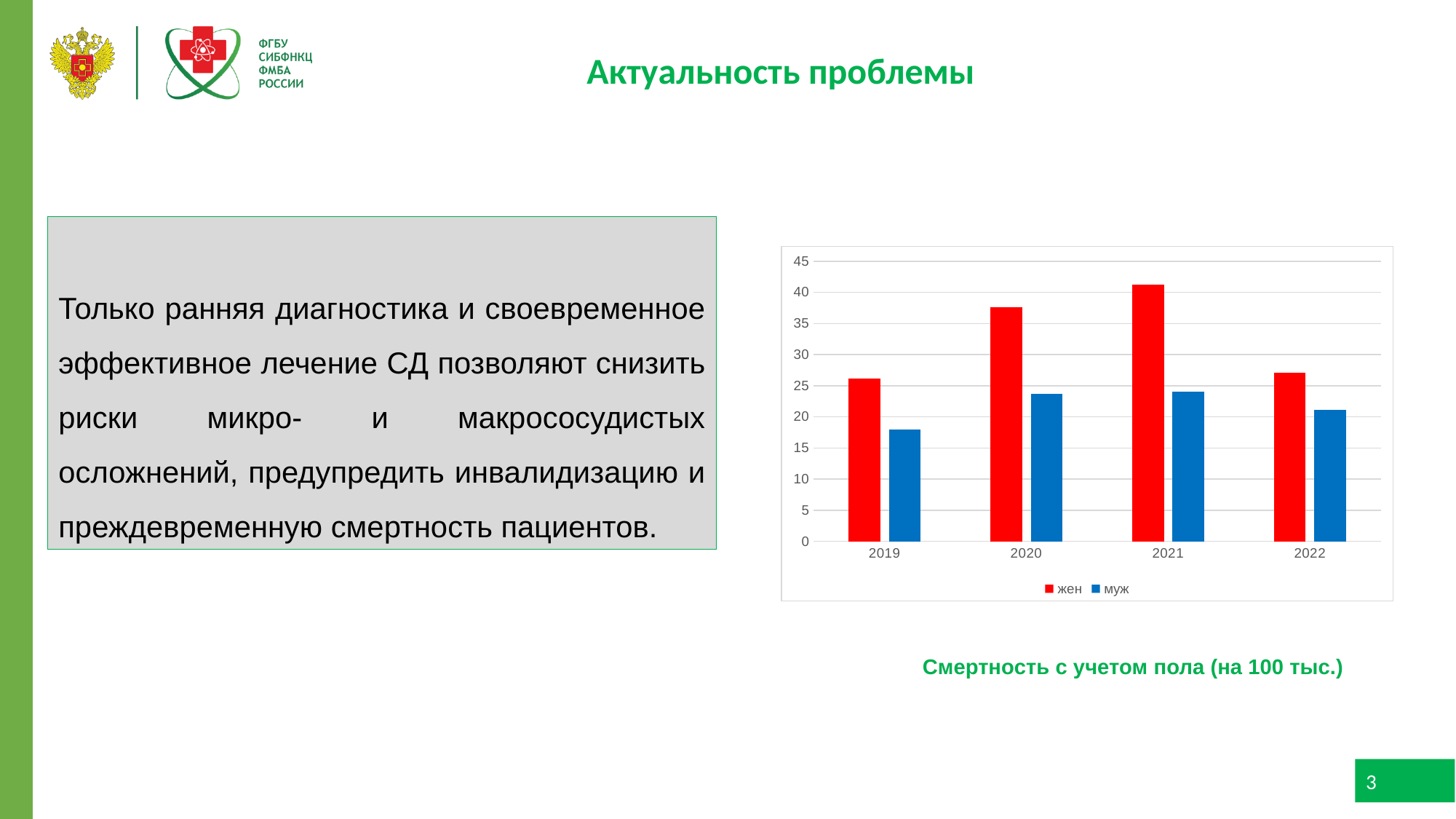
In which year is the value for муж lowest? 2019 Is the value for муж in 2019 greater or less than 20? less Is the value for жен in 2021 greater or less than 40? greater In 2021, which is larger: the value for жен or the value for муж? жен What kind of chart is shown on the slide? bar chart In which year is the value for жен highest? 2021 Is the value for жен in 2020 greater or less than 35? greater In 2019, which is larger: the value for жен or the value for муж? жен How many years are shown on the x axis of the chart? 4 How many series does the chart legend list? 2 Do the values for жен rise or fall from 2019 to 2021? rise What is the caption given for the chart on the slide? Смертность с учетом пола (на 100 тыс.)